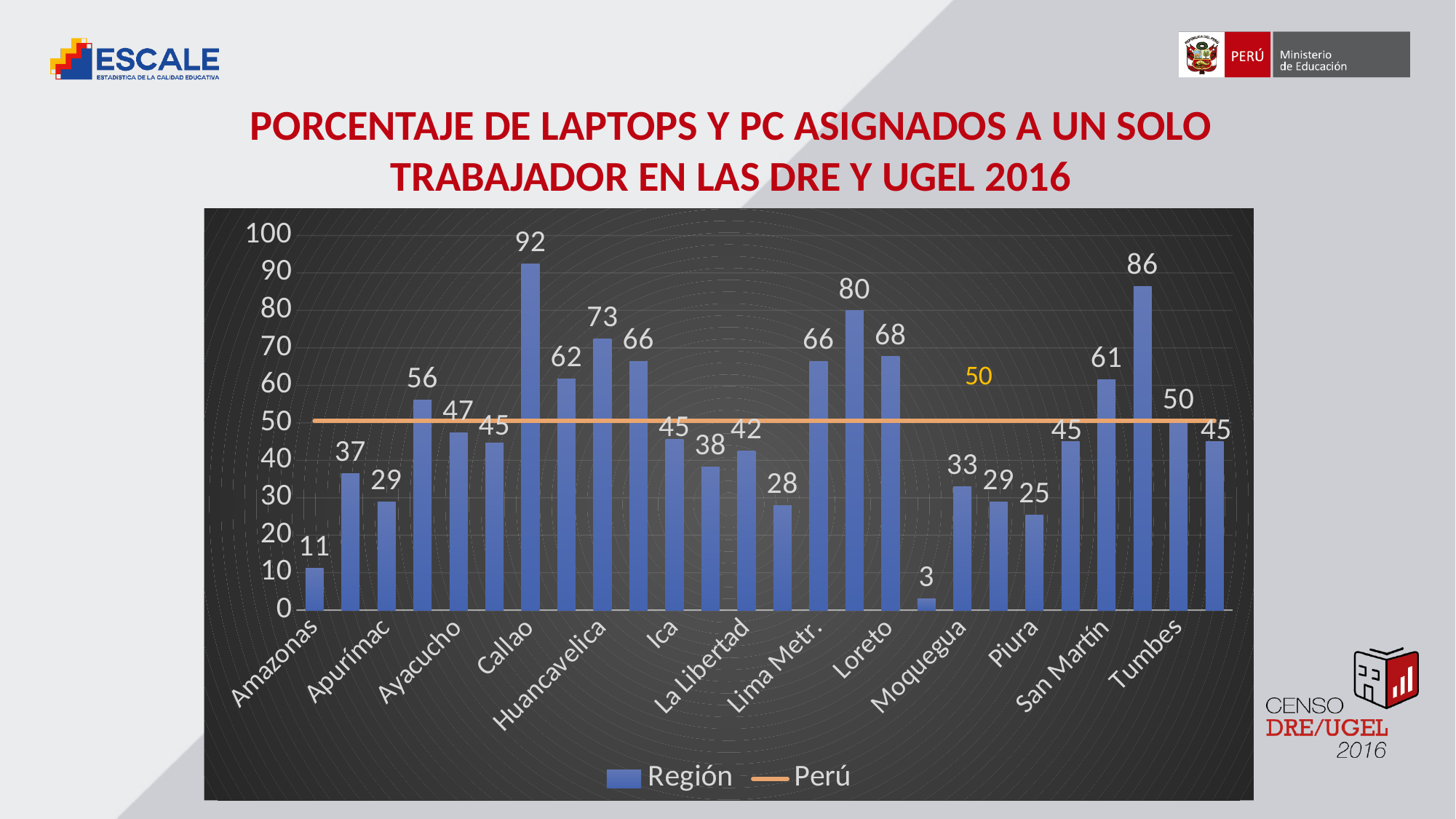
What is the value for Huancavelica? 73 What is the value for Callao? 92 What type of chart is shown on the slide? combination bar and line chart What is the lowest value shown by any bar in the chart? 3 What is the value for Lima Metr.? 66 What is the value for Amazonas? 11 What is the difference between the values for Callao and Amazonas? 81 How many series does the legend list? 2 What is the value of the Perú reference line? 50 Which labeled region has the highest value? Callao Which has a larger value, Loreto or Piura? Loreto Is the value for San Martín greater or less than the Perú line of 50? greater